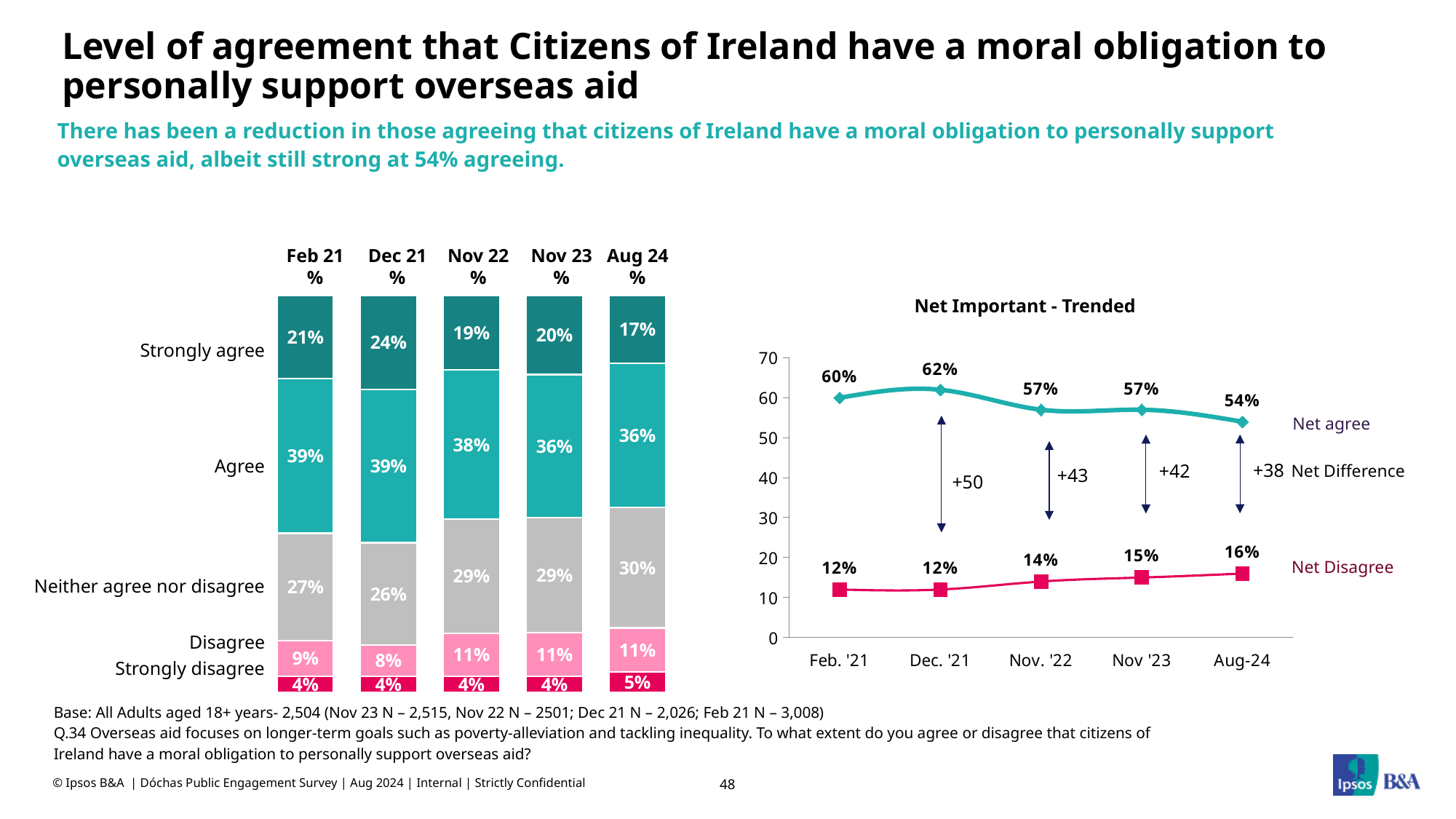
In the 'Net Important - Trended' chart, what is the Net Difference shown for Dec. '21? +50 In the stacked bar chart on the left, which wave has the highest 'Strongly agree' percentage? Dec 21 In the stacked bar chart on the left, how many survey waves are shown? 5 In the 'Net Important - Trended' chart, does Net Disagree rise or fall from Feb. '21 to Aug-24? Rise In the stacked bar chart on the left, what percentage strongly agreed in Dec 21? 24% In the 'Net Important - Trended' chart, which is larger: Net agree in Feb. '21 or Net agree in Dec. '21? Dec. '21 In the stacked bar chart on the left, which wave has the lowest 'Strongly agree' percentage? Aug 24 What type of chart is the 'Net Important - Trended' chart? Line chart In the stacked bar chart on the left, what percentage said 'Neither agree nor disagree' in Aug 24? 30% In the 'Net Important - Trended' chart, what is the Net agree value for Nov '22? 57% In the 'Net Important - Trended' chart, what is the Net Disagree value for Aug-24? 16% In the stacked bar chart on the left, what is the difference between the 'Agree' percentage in Feb 21 and in Aug 24? 3 percentage points